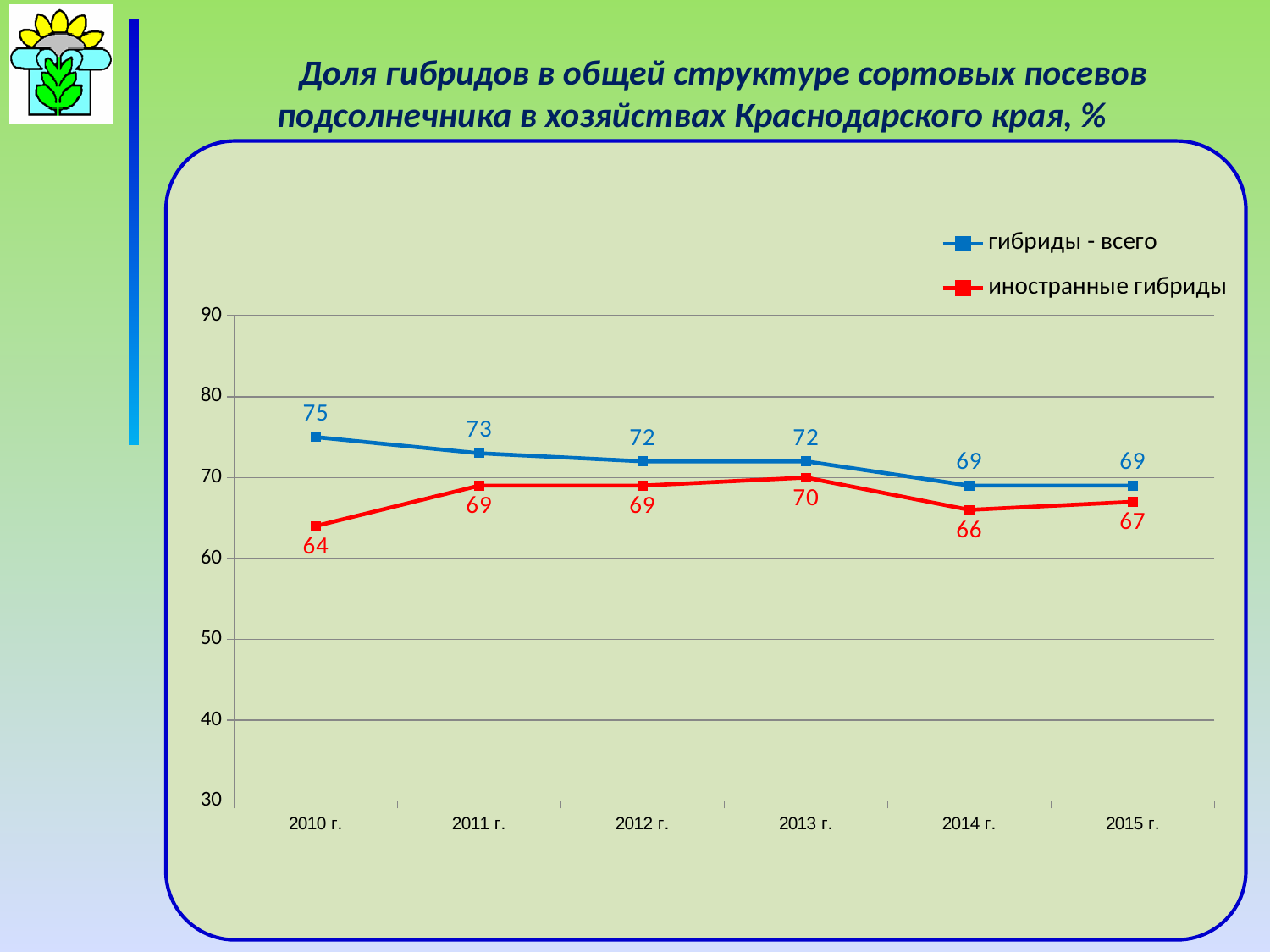
What is the difference between the "гибриды - всего" values in 2010 г. and 2015 г.? 6 What is the difference between "гибриды - всего" and "иностранные гибриды" in 2010 г.? 11 How many years are shown on the x axis? 6 Does the "гибриды - всего" series generally rise or fall from 2010 г. to 2015 г.? fall What kind of chart is shown on the slide? line chart In which year is the value for "иностранные гибриды" lowest? 2010 г. What is the value for "гибриды - всего" in 2010 г.? 75 What is the value for "иностранные гибриды" in 2014 г.? 66 How many series does the legend list? 2 What is the value for "иностранные гибриды" in 2013 г.? 70 Which series has the larger value in 2012 г., "гибриды - всего" or "иностранные гибриды"? гибриды - всего In which year is the value for "гибриды - всего" highest? 2010 г.